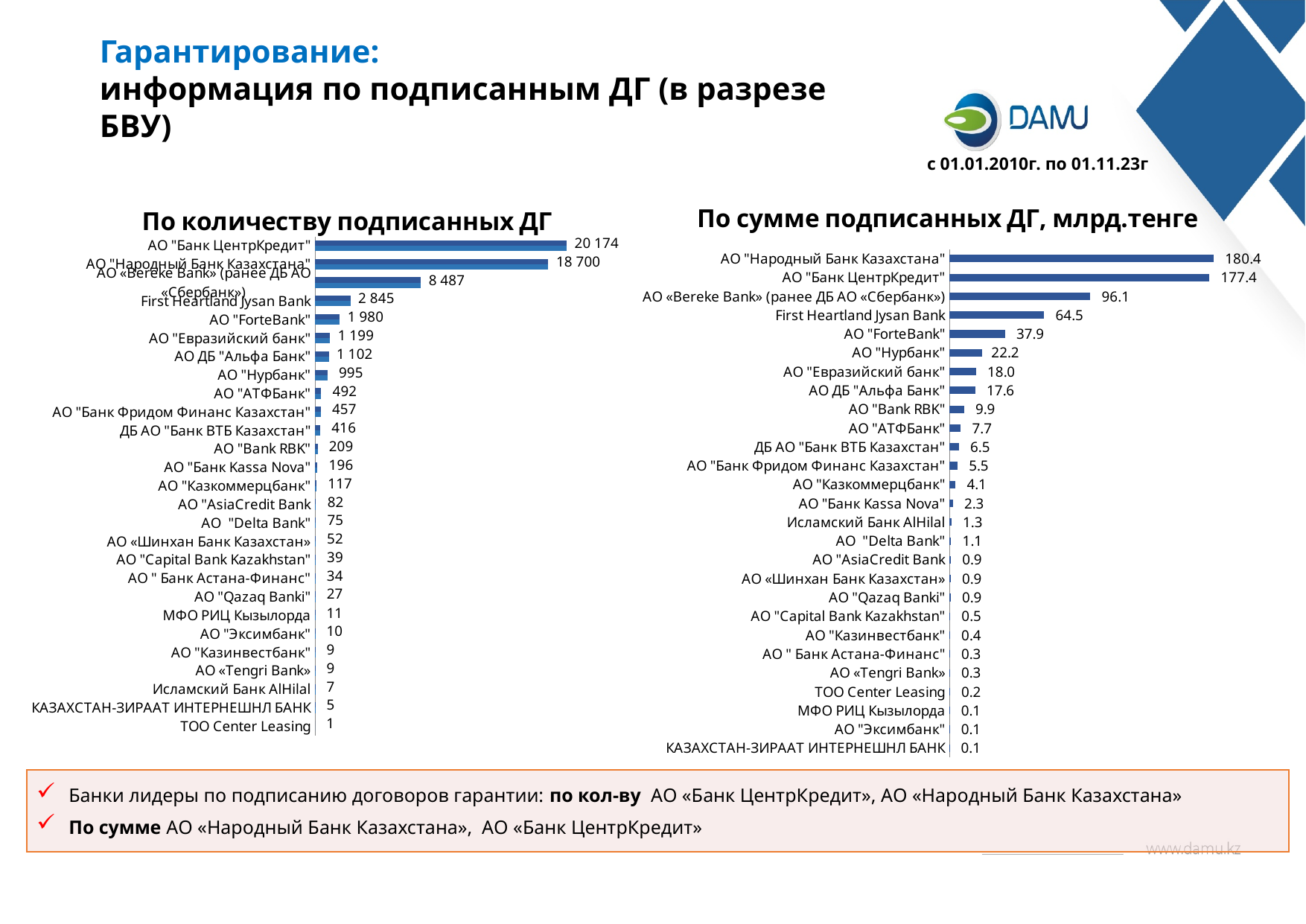
In the chart "По сумме подписанных ДГ, млрд.тенге", what is the value for АО "Народный Банк Казахстана"? 180.4 In the chart "По сумме подписанных ДГ, млрд.тенге", which is larger: АО "Нурбанк" or АО "Bank RBK"? АО "Нурбанк" In the chart "По сумме подписанных ДГ, млрд.тенге", what is the difference between АО "Народный Банк Казахстана" and АО "Банк ЦентрКредит"? 3.0 In the chart "По количеству подписанных ДГ", what is the value for АО "Нурбанк"? 995 In the chart "По количеству подписанных ДГ", which category has the lowest value? ТОО Center Leasing In the chart "По количеству подписанных ДГ", which bank has the highest value? АО "Банк ЦентрКредит" What type of chart is "По сумме подписанных ДГ, млрд.тенге"? Bar chart In the chart "По количеству подписанных ДГ", what is the difference between АО "Банк ЦентрКредит" and АО "Народный Банк Казахстана"? 1 474 In the chart "По количеству подписанных ДГ", which is larger: АО "ForteBank" or АО "Евразийский банк"? АО "ForteBank" In the chart "По сумме подписанных ДГ, млрд.тенге", which bank has the highest value? АО "Народный Банк Казахстана" In the chart "По количеству подписанных ДГ", what is the value for АО "Банк ЦентрКредит"? 20 174 In the chart "По сумме подписанных ДГ, млрд.тенге", what is the value for First Heartland Jysan Bank? 64.5